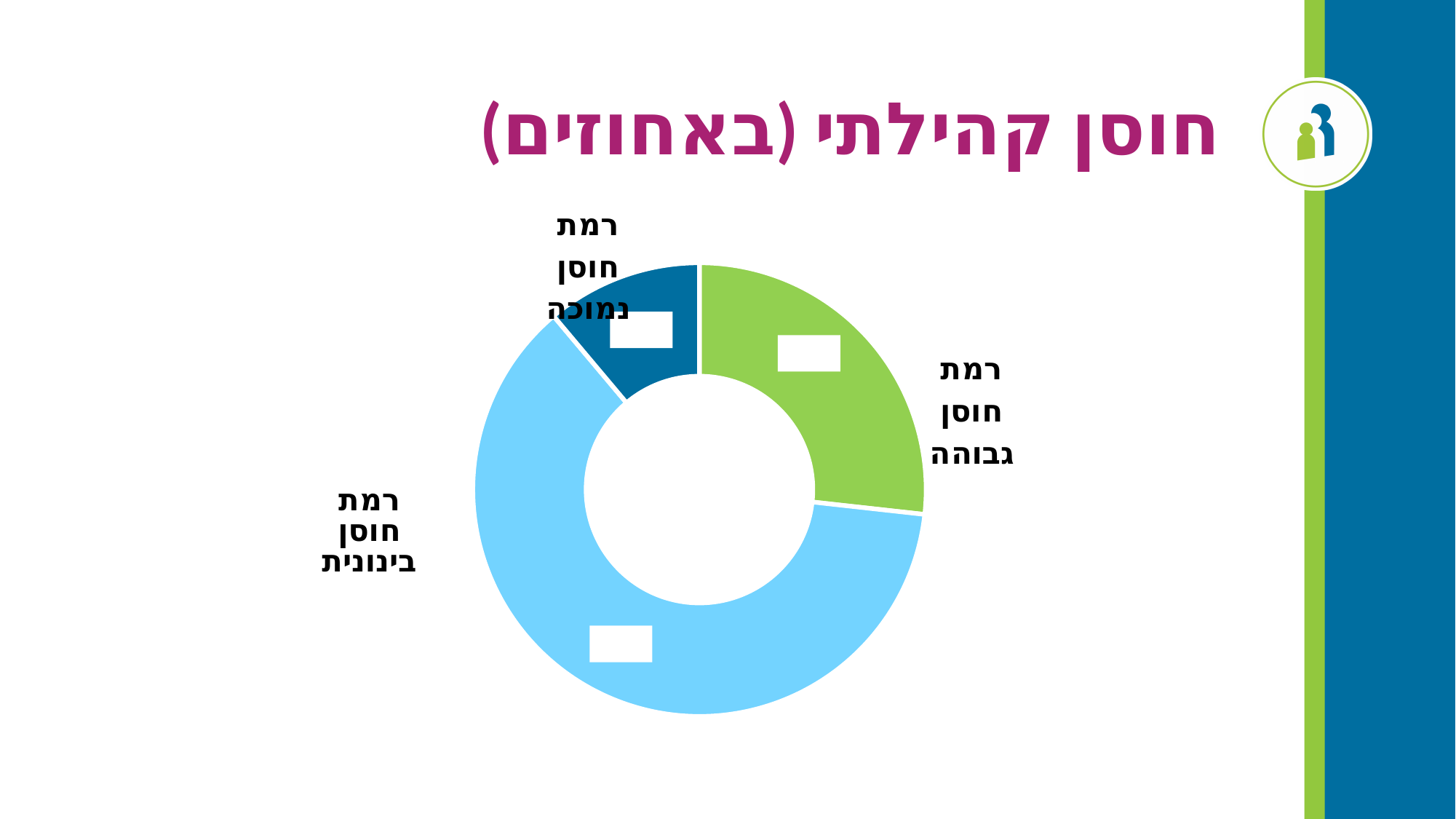
Which category has the largest slice? רמת חוסן בינונית How many categories (slices) does the chart have? 3 What colour is the slice for רמת חוסן גבוהה? Green Which is larger, the slice for רמת חוסן בינונית or the slice for רמת חוסן גבוהה? רמת חוסן בינונית Which is larger, the slice for רמת חוסן גבוהה or the slice for רמת חוסן נמוכה? רמת חוסן גבוהה What kind of chart is shown on the slide? Donut (pie) chart What is the title of the chart? חוסן קהילתי (באחוזים) Which category has the smallest slice? רמת חוסן נמוכה Does the slice for רמת חוסן בינונית take up more or less than half of the chart? more